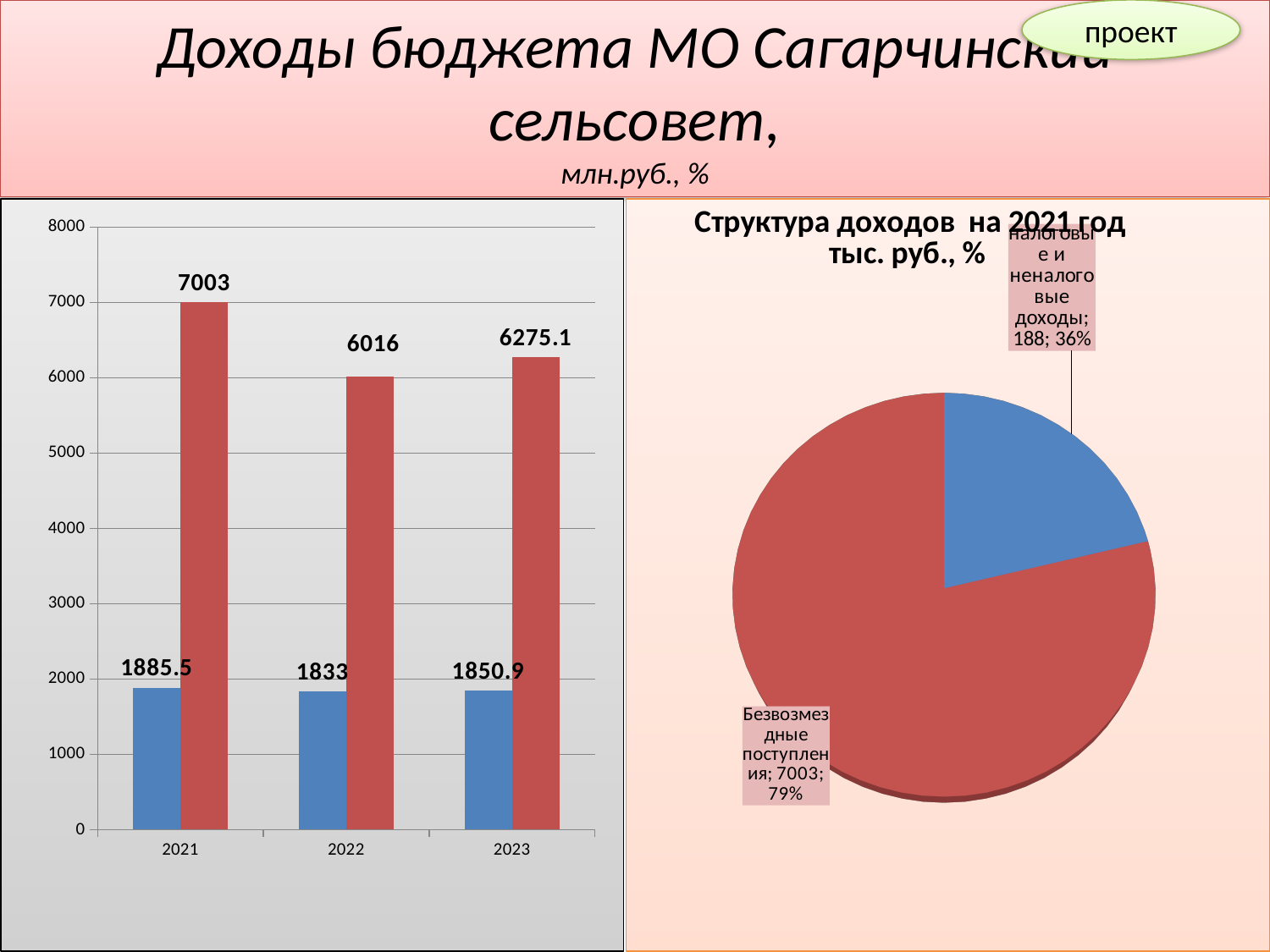
In the bar chart on the left, which is larger: the red bar for 2022 or the red bar for 2023? 2023 In the bar chart on the left, how many years are shown on the x axis? 3 In the pie chart 'Структура доходов на 2021 год', what share does 'Безвозмездные поступления' have? 79% In the bar chart on the left, which year has the highest red bar? 2021 What kind of chart is shown on the left side of the slide? Bar chart In the bar chart on the left, which year has the lowest blue bar? 2022 How many slices does the pie chart 'Структура доходов на 2021 год' have? 2 In the bar chart on the left, what is the value of the red bar for 2021? 7003 In the bar chart on the left, what is the difference between the red bar values for 2021 and 2022? 987 In the bar chart on the left, what is the value of the blue bar for 2022? 1833 In the bar chart on the left, what is the value of the red bar for 2023? 6275.1 In the pie chart 'Структура доходов на 2021 год', what value is shown for 'Налоговые и неналоговые доходы'? 188